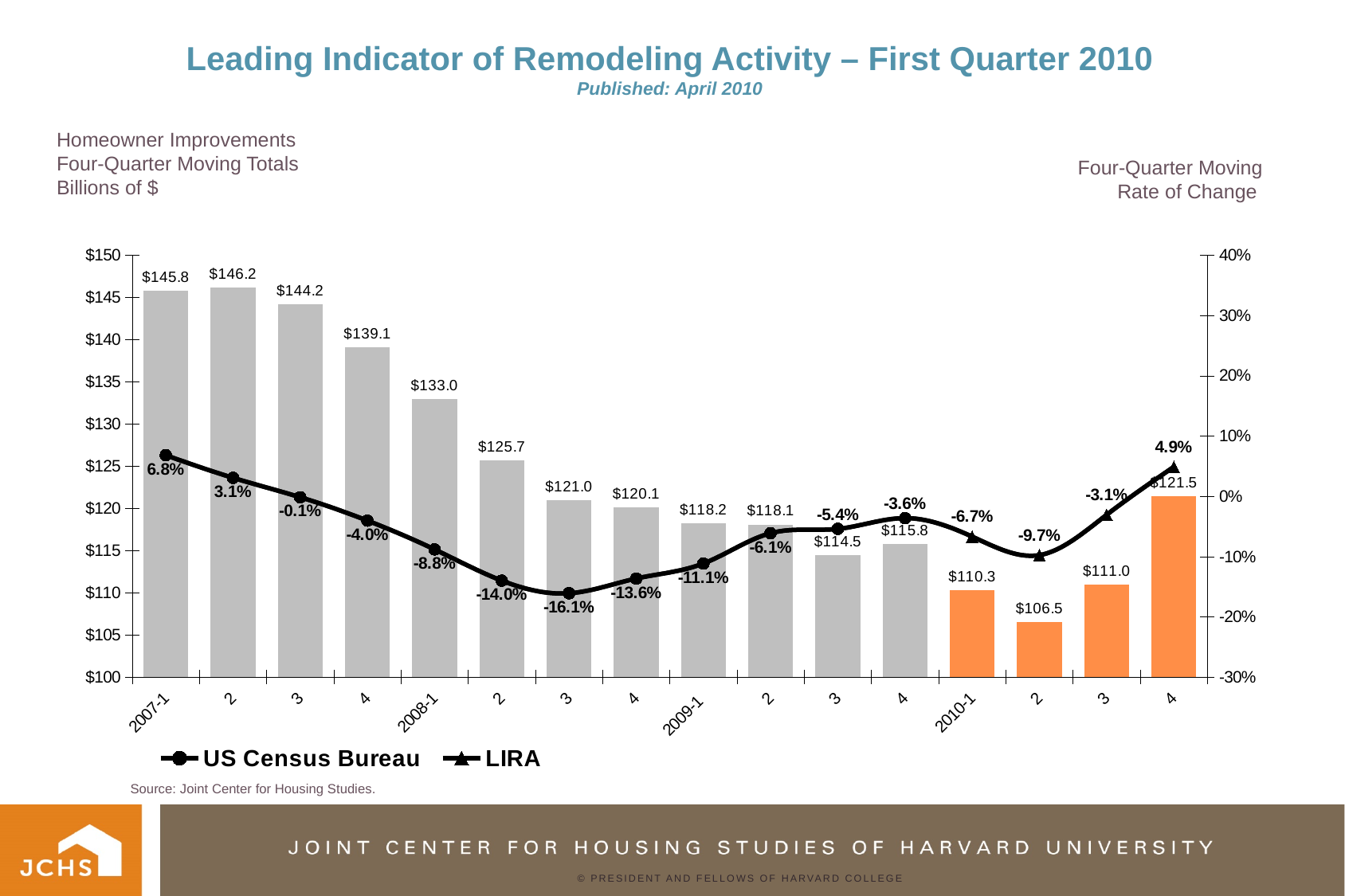
What is the four-quarter moving total for 2008-1? $133.0 Which quarter has the lowest four-quarter moving total bar? 2010-2 Which has the larger four-quarter moving total, 2009-3 or 2009-4? 2009-4 Do the four-quarter moving total bars rise or fall from 2007-1 to 2010-2? Fall How many series does the legend list? 2 Which quarter has the highest four-quarter moving total bar? 2007-2 How many quarterly bars are plotted on the chart? 16 What kind of chart is shown on the slide? Combined bar and line chart What is the LIRA rate of change shown for 2010-4? 4.9% Which quarter has the lowest four-quarter moving rate of change on the line? 2008-3 What is the difference between the four-quarter moving totals for 2007-1 and 2010-4? $24.3 What is the four-quarter moving rate of change shown for 2008-3? -16.1%